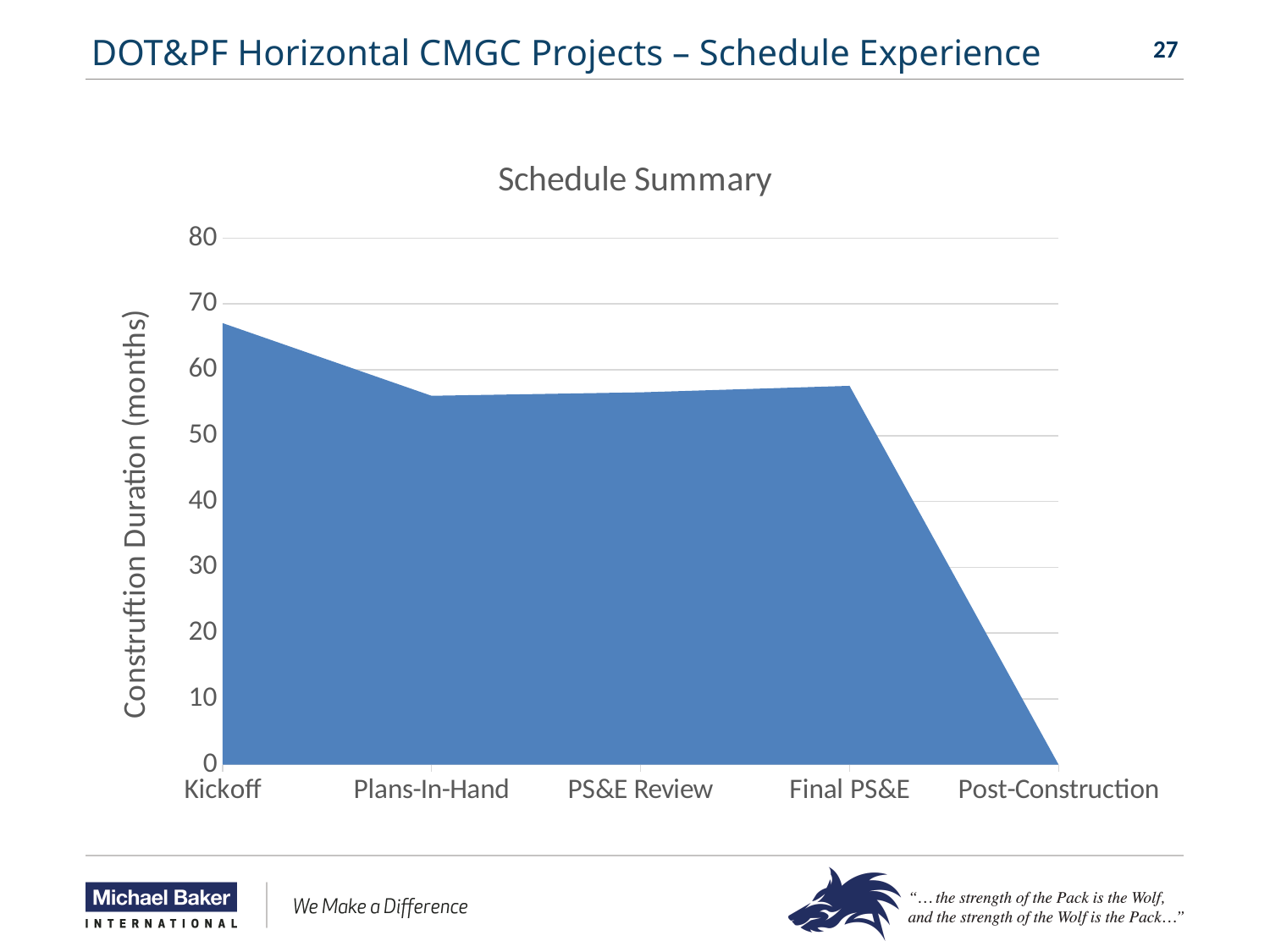
Is the value for Final PS&E greater or less than 50? greater Do the values generally rise or fall from Kickoff to Post-Construction? fall Which category has the lowest construction duration? Post-Construction What is the title of the chart? Schedule Summary Which category has the highest construction duration? Kickoff Is the value for Kickoff greater or less than 60? greater What kind of chart is shown on the slide? Area chart What is the construction duration value for Post-Construction? 0 Which is larger, the value for Kickoff or the value for Plans-In-Hand? Kickoff Is the value for Plans-In-Hand greater or less than 60? less What is the label of the vertical axis? Construftion Duration (months) How many categories are shown along the x axis? 5